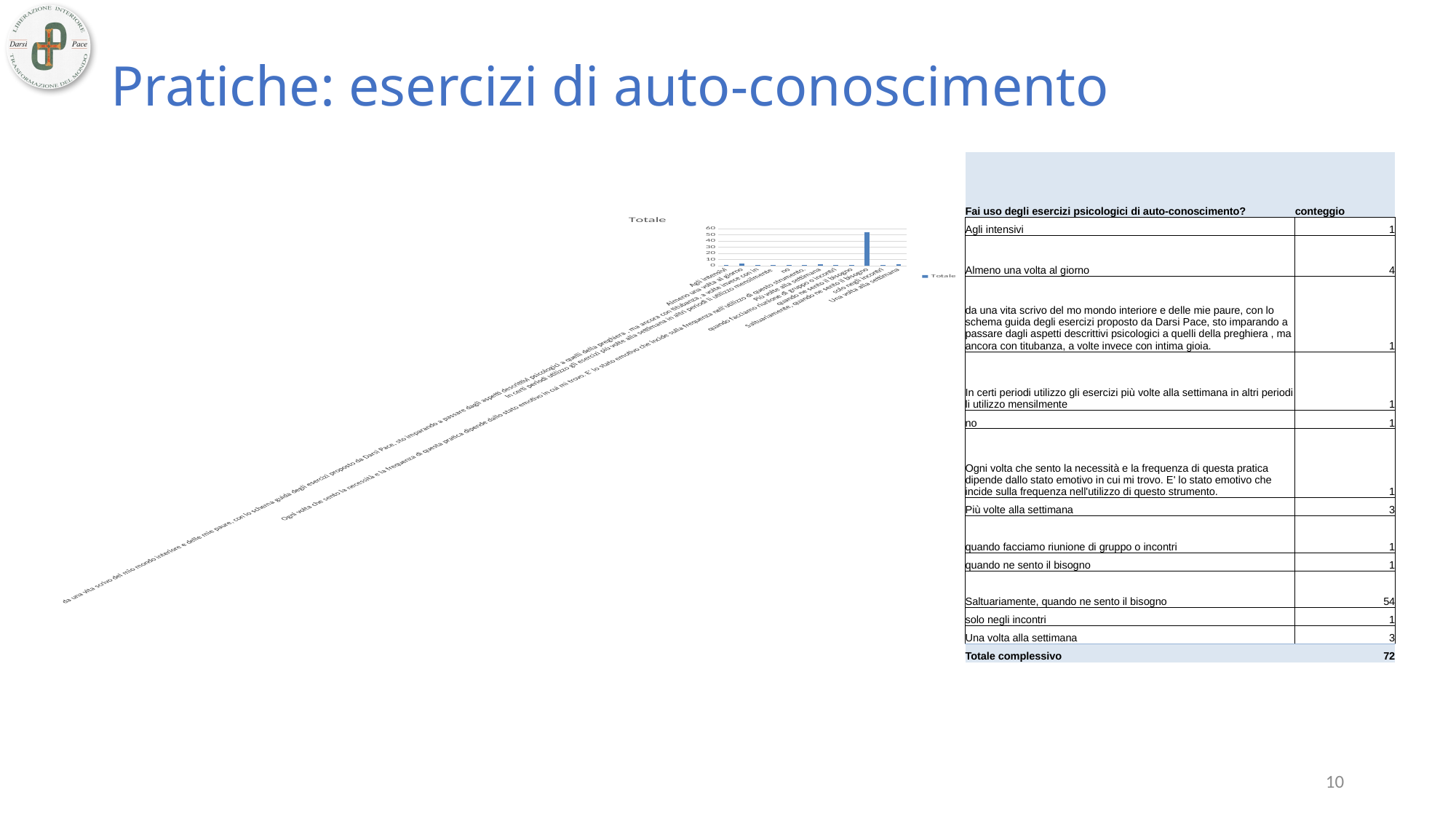
How many series does the chart legend list? 1 How many categories (bars) are plotted in the chart? 12 According to the table on the slide, what is the count for 'Saltuariamente, quando ne sento il bisogno'? 54 Which is larger, the value for 'Saltuariamente, quando ne sento il bisogno' or the value for 'Una volta alla settimana'? Saltuariamente, quando ne sento il bisogno According to the table on the slide, what is the count for 'Almeno una volta al giorno'? 4 Is the value for 'Agli intensivi' greater or less than 10? less What is the 'Totale complessivo' shown in the table? 72 What is the difference between the count for 'Saltuariamente, quando ne sento il bisogno' and the count for 'Più volte alla settimana'? 51 What is the title of the chart? Totale Is the value for 'Saltuariamente, quando ne sento il bisogno' greater or less than 40? greater What kind of chart is shown on the slide? bar chart Which category has the highest bar in the chart? Saltuariamente, quando ne sento il bisogno